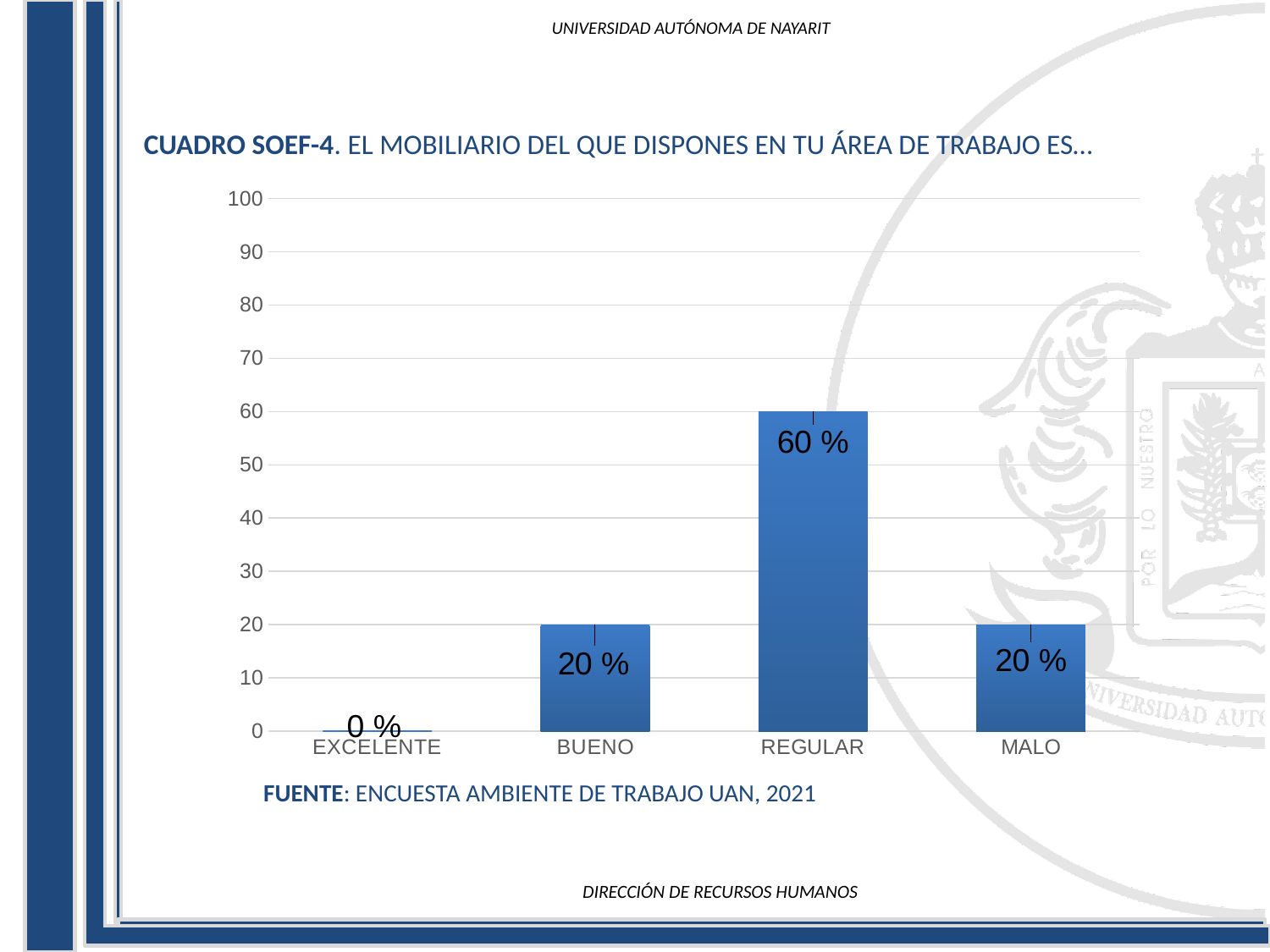
What source is cited below the chart? ENCUESTA AMBIENTE DE TRABAJO UAN, 2021 Which category has the lowest value? EXCELENTE What is the difference between the values for REGULAR and BUENO? 40 % What is the value for BUENO? 20 % What is the value for EXCELENTE? 0 % Which category has the highest value? REGULAR What kind of chart is shown on the slide? bar chart What is the value for REGULAR? 60 % What is the value for MALO? 20 % Which is larger, the value for REGULAR or the value for MALO? REGULAR Is the value for REGULAR greater or less than 50? greater How many categories are shown on the x axis? 4